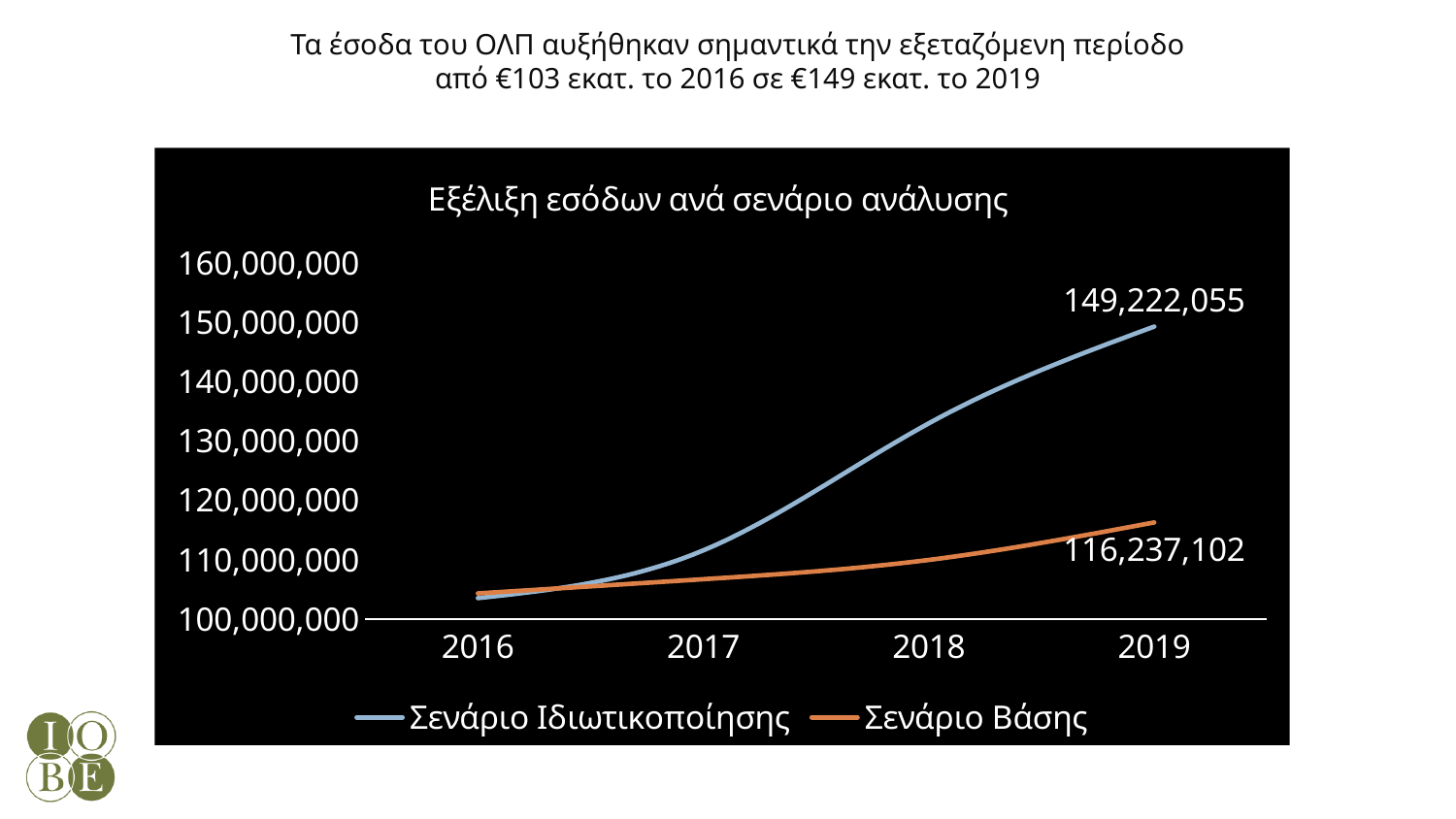
What is the value of Σενάριο Βάσης in 2019? 116,237,102 What is the title of the chart? Εξέλιξη εσόδων ανά σενάριο ανάλυσης Do the values for Σενάριο Ιδιωτικοποίησης rise or fall from 2016 to 2019? rise How many series does the legend list? 2 Is the value for Σενάριο Ιδιωτικοποίησης in 2017 greater or less than 120,000,000? less Is the value for Σενάριο Βάσης in 2018 greater or less than 120,000,000? less Which series has the higher value in 2019? Σενάριο Ιδιωτικοποίησης What is the difference between the two series' values in 2019? 32,984,953 What kind of chart is shown? line chart Is the value for Σενάριο Ιδιωτικοποίησης in 2018 greater or less than 130,000,000? greater How many years are shown on the x axis? 4 What is the value of Σενάριο Ιδιωτικοποίησης in 2019? 149,222,055